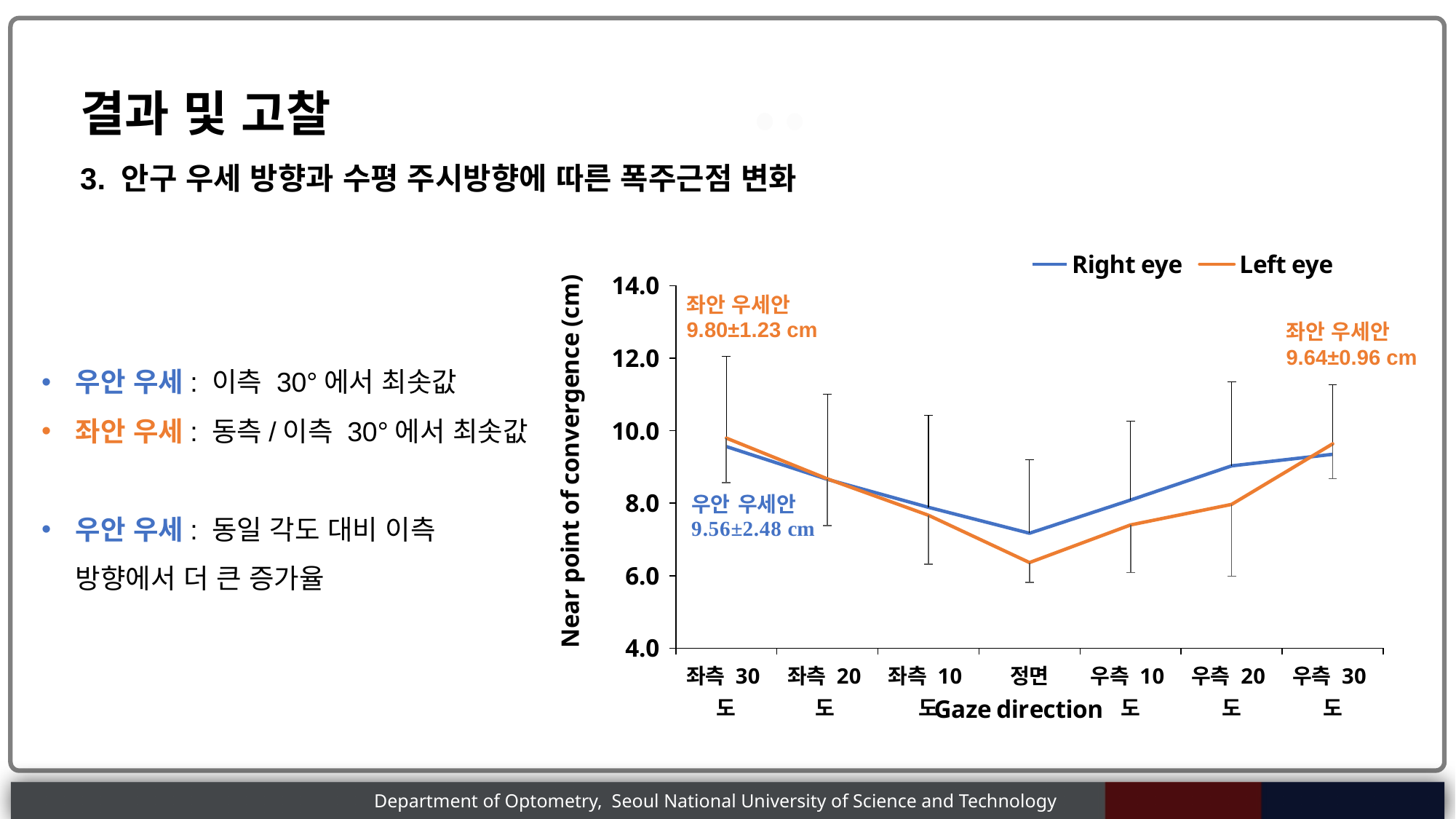
How many gaze direction categories are plotted along the x axis? 7 What is the labelled Left eye value at 좌측 30도? 9.80±1.23 cm Is the Left eye value at 정면 greater or less than 8.0? less How many series does the chart legend list? 2 What is the labelled Right eye value at 좌측 30도? 9.56±2.48 cm At 정면, which series has the larger value, Right eye or Left eye? Right eye What is the labelled Left eye value at 우측 30도? 9.64±0.96 cm Is the Right eye value at 우측 20도 greater or less than 8.0? greater At which gaze direction does the Left eye series reach its lowest value? 정면 What is the label of the y axis? Near point of convergence (cm) At which gaze direction does the Right eye series reach its lowest value? 정면 What kind of chart is shown on the slide? line chart